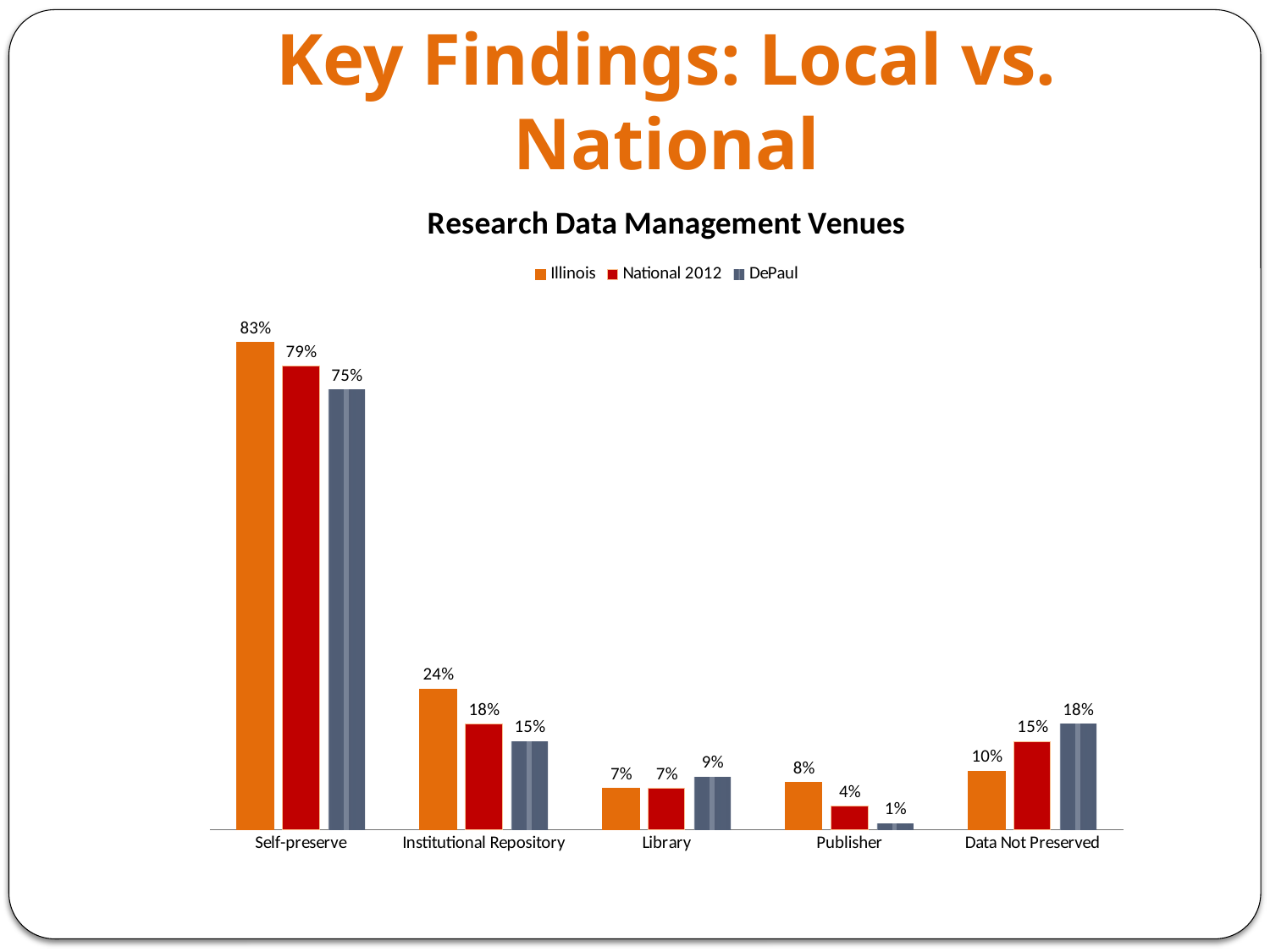
Which is larger for Data Not Preserved: the Illinois value or the DePaul value? DePaul How many categories are shown on the x axis? 5 What kind of chart is shown on the slide? Bar chart What is the DePaul value for Institutional Repository? 15% Which category has the lowest DePaul value? Publisher What is the National 2012 value for Publisher? 4% Which category has the highest Illinois value? Self-preserve How many series does the legend list? 3 What is the title of the chart? Research Data Management Venues What is the Illinois value for Self-preserve? 83% What is the difference between the Illinois and DePaul values for Self-preserve? 8% What is the DePaul value for Data Not Preserved? 18%